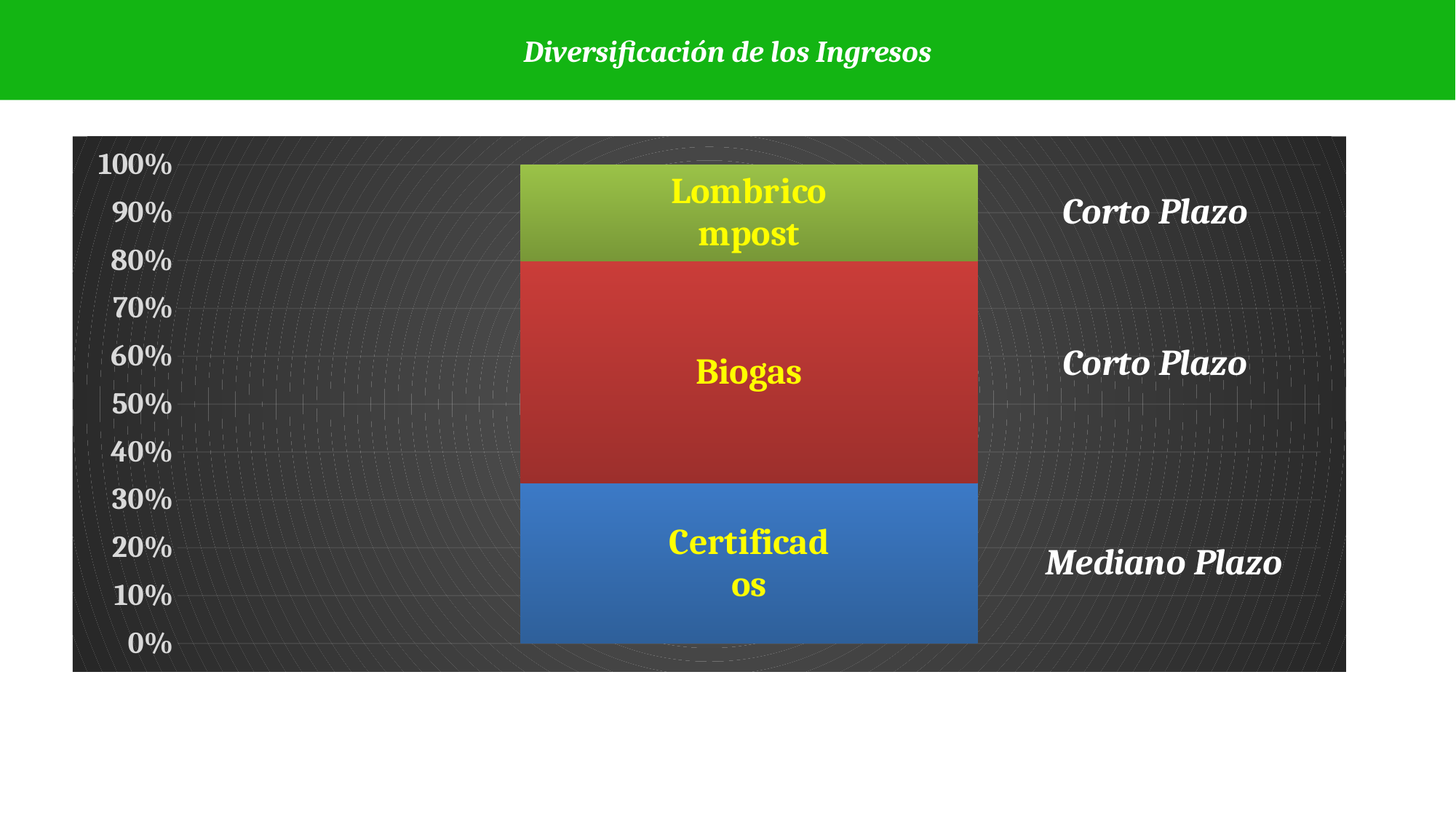
How many segments make up the stacked bar? 3 Which segment of the stacked bar is the largest? Biogas Is the share for Biogas greater or less than 40%? greater Which segment of the bar is labelled 'Mediano Plazo' on the right? Certificados Which segment of the stacked bar is the smallest? Lombricompost Is the share for Certificados greater or less than 40%? less What is the total height of the stacked bar on the percentage axis? 100% Is the share for Lombricompost greater or less than 30%? less What is the title of the slide containing the chart? Diversificación de los Ingresos Which segment is larger, Certificados or Lombricompost? Certificados What kind of chart is shown on the slide? Stacked bar chart Which segment is larger, Biogas or Certificados? Biogas